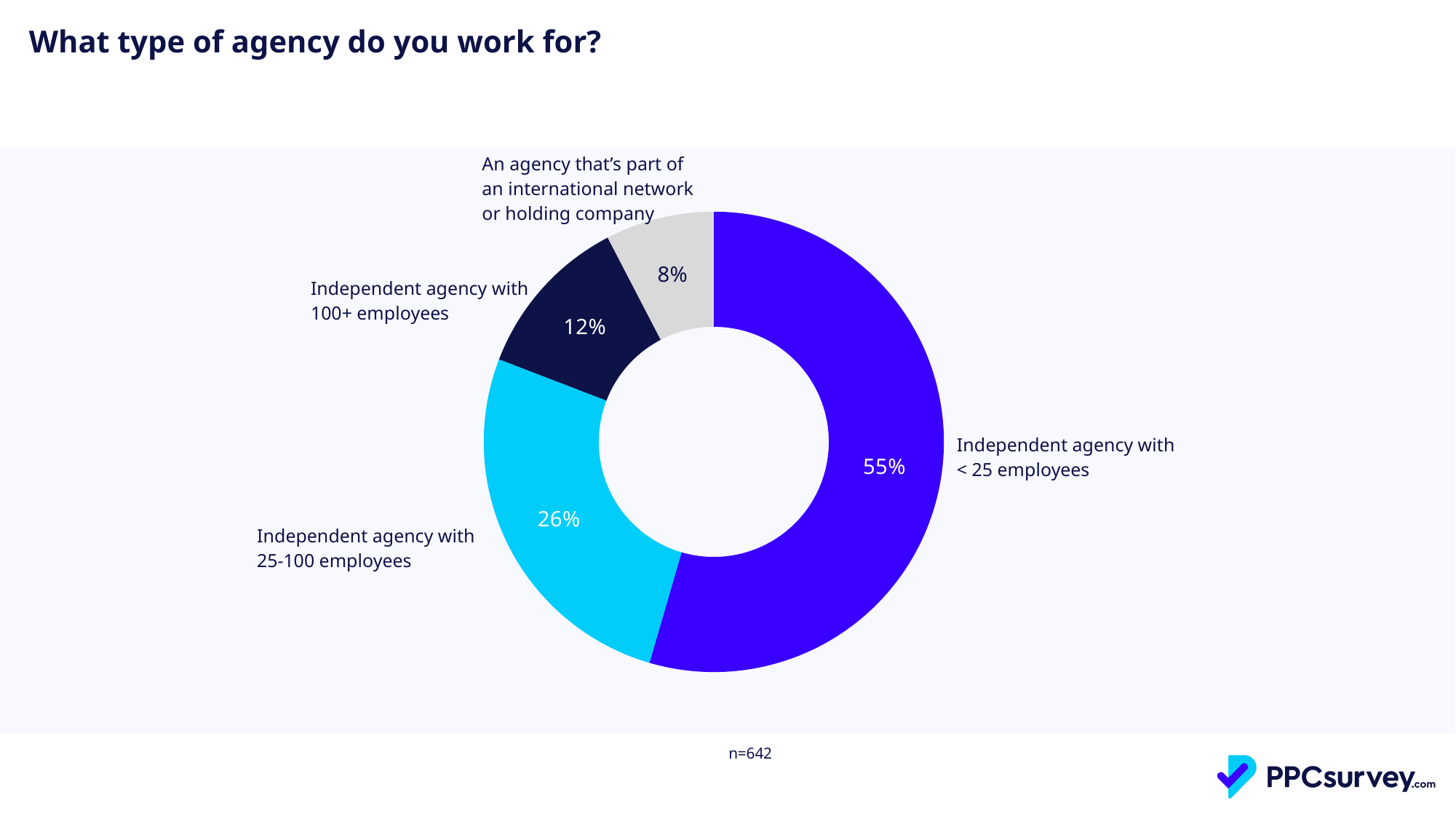
What share of respondents work for an independent agency with 100+ employees? 12% What is the sample size (n) shown on the slide? n=642 What is the title of the chart? What type of agency do you work for? Which is larger: the share for independent agencies with 100+ employees or the share for agencies that are part of an international network or holding company? Independent agency with 100+ employees What kind of chart is shown on the slide? Donut (pie) chart What is the difference in percentage points between the share for independent agencies with < 25 employees and those with 25-100 employees? 29 How many agency types are shown in the chart? 4 What share of respondents work for an independent agency with < 25 employees? 55% What share of respondents work for an independent agency with 25-100 employees? 26% Which agency type has the smallest share? An agency that's part of an international network or holding company Which agency type has the largest share? Independent agency with < 25 employees What share of respondents work for an agency that's part of an international network or holding company? 8%